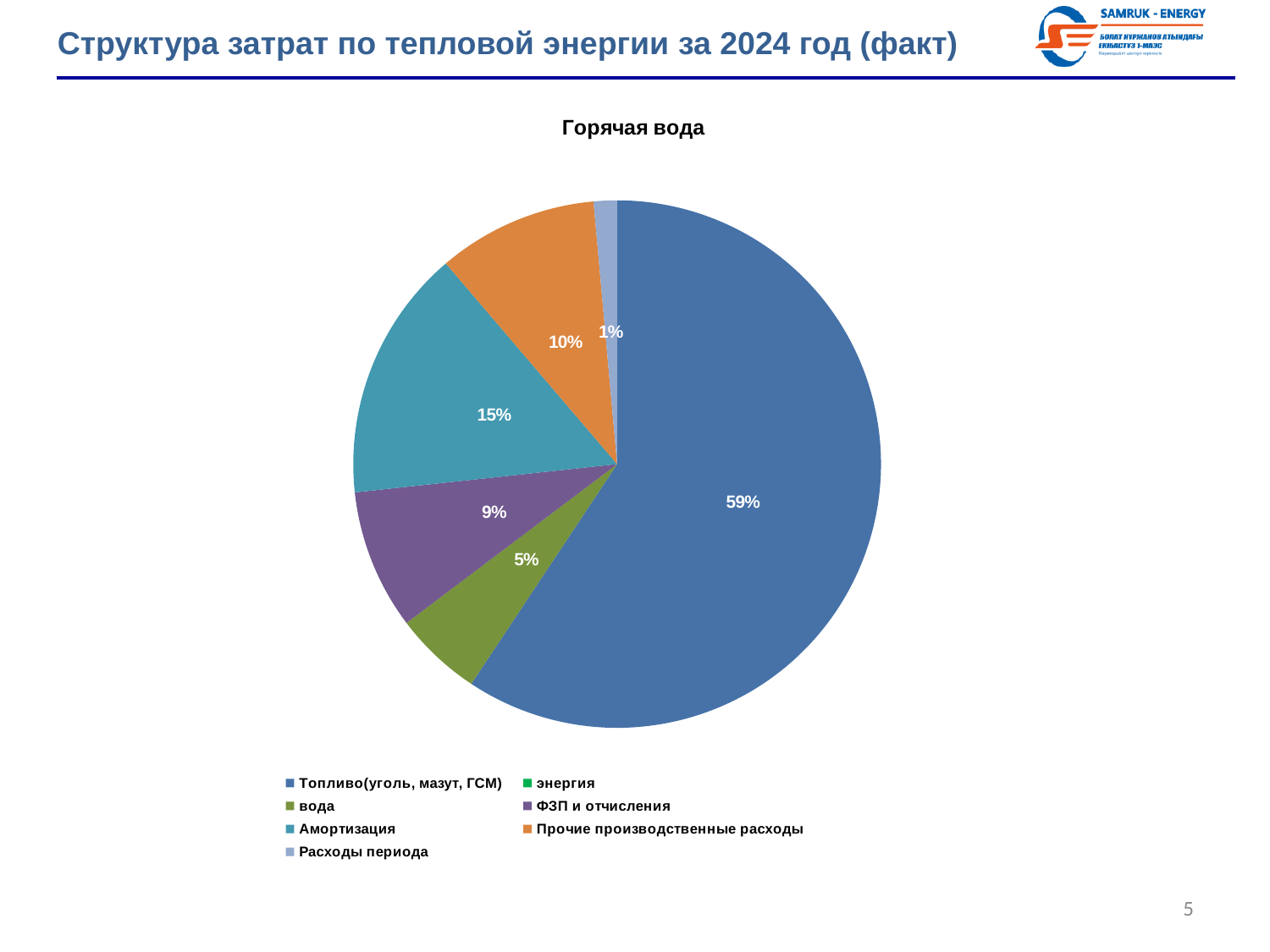
Which of the labelled slices is the smallest? Расходы периода What share of the pie does вода take? 5% How many categories does the legend list? 7 What kind of chart is shown on the slide? pie chart What share of the pie does Прочие производственные расходы take? 10% What share of the pie does Расходы периода take? 1% Which category has the largest slice of the pie? Топливо(уголь, мазут, ГСМ) What is the title of the chart? Горячая вода What is the difference between the shares of Амортизация and ФЗП и отчисления? 6%